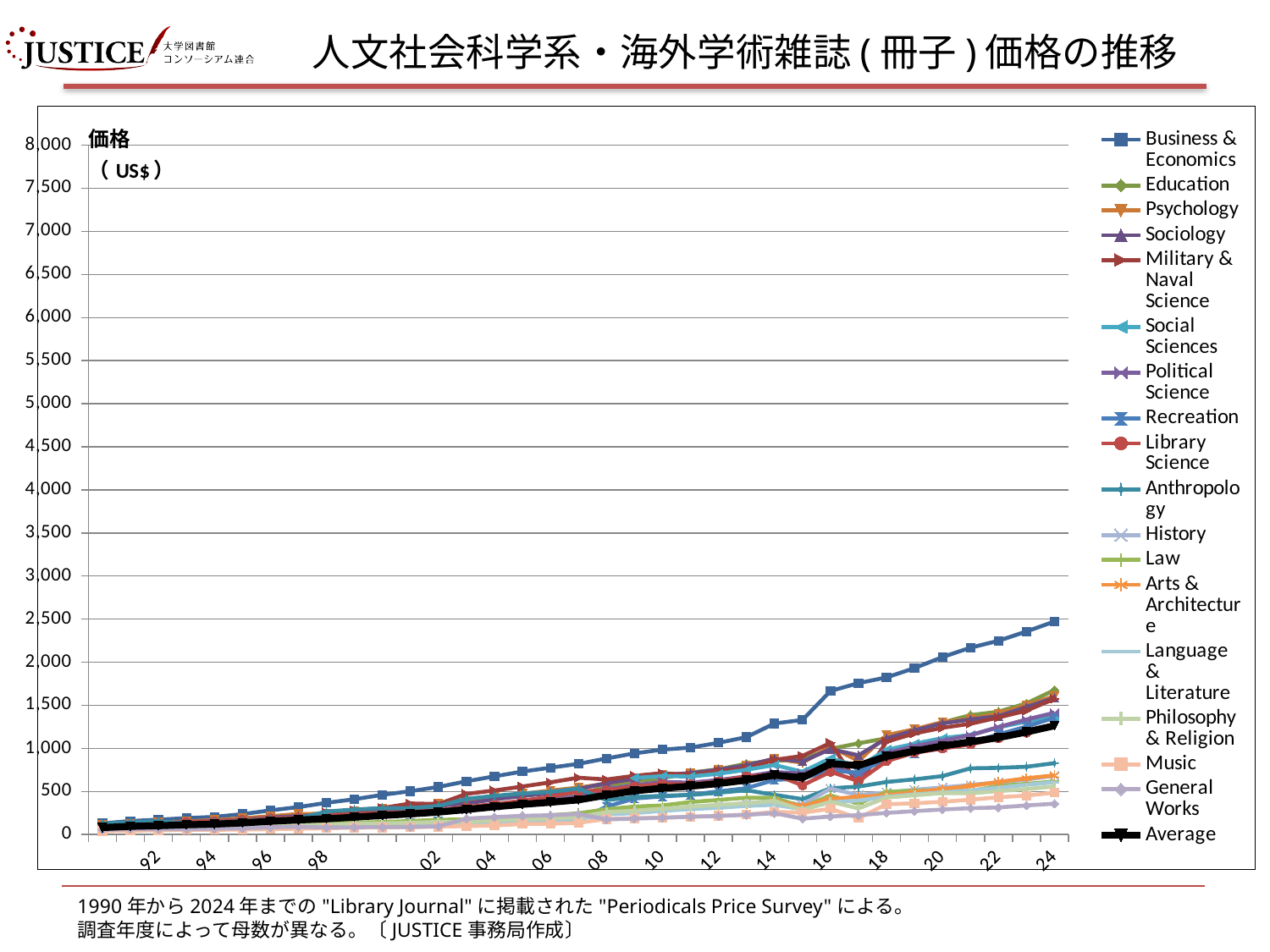
How many series does the legend list? 18 Is the value for General Works at 24 greater or less than 500? less Is the value for Business & Economics at 24 greater or less than 2,000? greater What unit is given for the vertical axis label? US$ Which series has the highest value at the right end of the chart (24)? Business & Economics What is the highest value shown on the vertical axis? 8,000 Which series has the lowest value at the right end of the chart (24)? General Works What kind of chart is shown on the slide? line chart Is the value for Business & Economics at 16 greater or less than 1,000? greater At 24, which is larger: Business & Economics or Average? Business & Economics Do the values for Business & Economics rise or fall along the x axis? rise